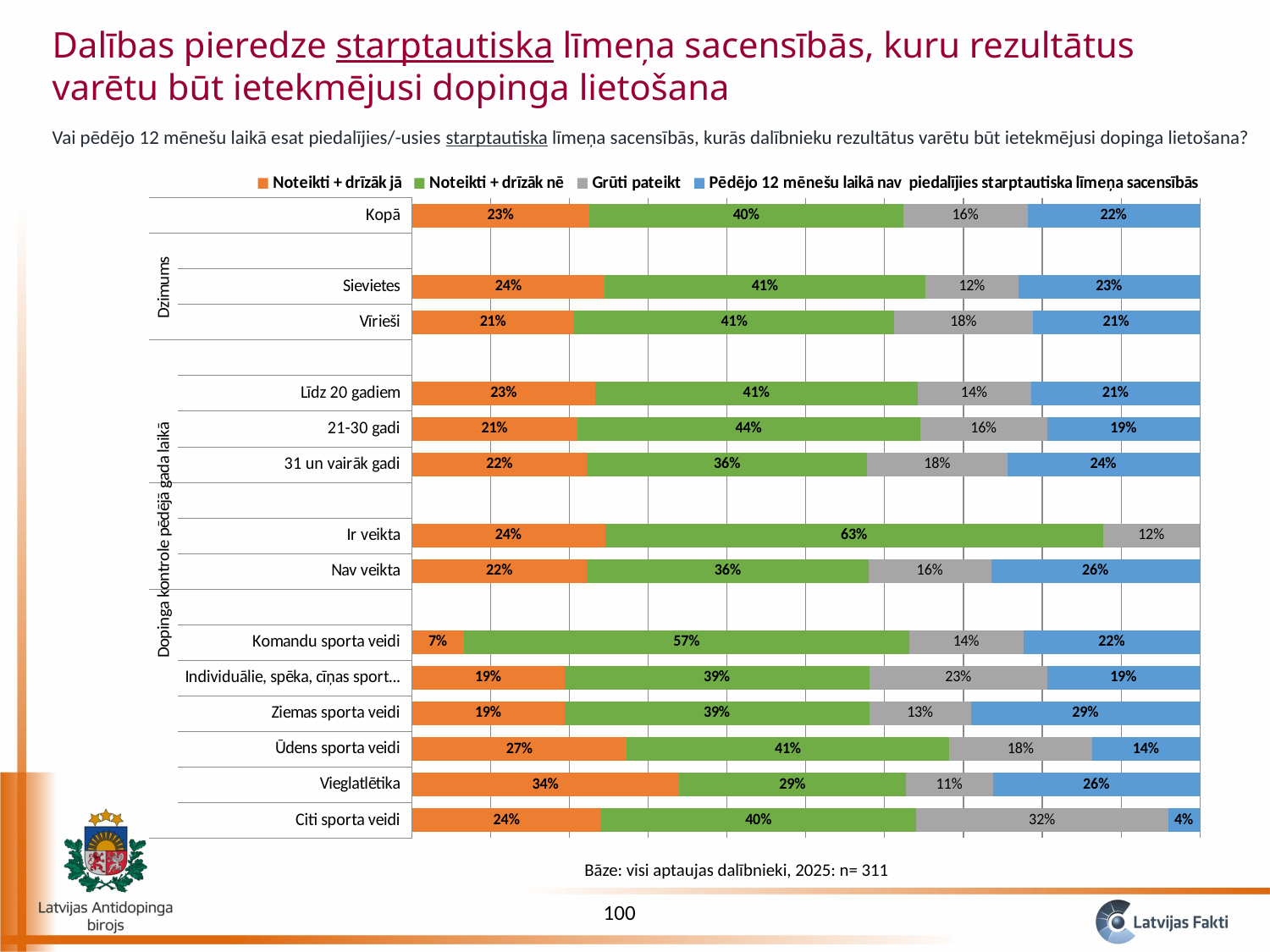
How many series does the legend list? 4 What type of chart is shown on the slide? stacked bar chart What is the difference between the "Noteikti + drīzāk nē" values for Komandu sporta veidi and Vieglatlētika? 28% What is the value of "Noteikti + drīzāk jā" for Kopā? 23% What is the value of "Noteikti + drīzāk nē" for Ir veikta? 63% Which category has the lowest value for "Noteikti + drīzāk jā"? Komandu sporta veidi How many categories are plotted on the chart? 14 What is the value of "Pēdējo 12 mēnešu laikā nav piedalījies starptautiska līmeņa sacensībās" for Ziemas sporta veidi? 29% What is the value of "Grūti pateikt" for Citi sporta veidi? 32% Which category has the highest value for "Noteikti + drīzāk jā"? Vieglatlētika Which is larger: the "Grūti pateikt" value for Sievietes or for Vīrieši? Vīrieši What is the base (n) stated below the chart? n= 311